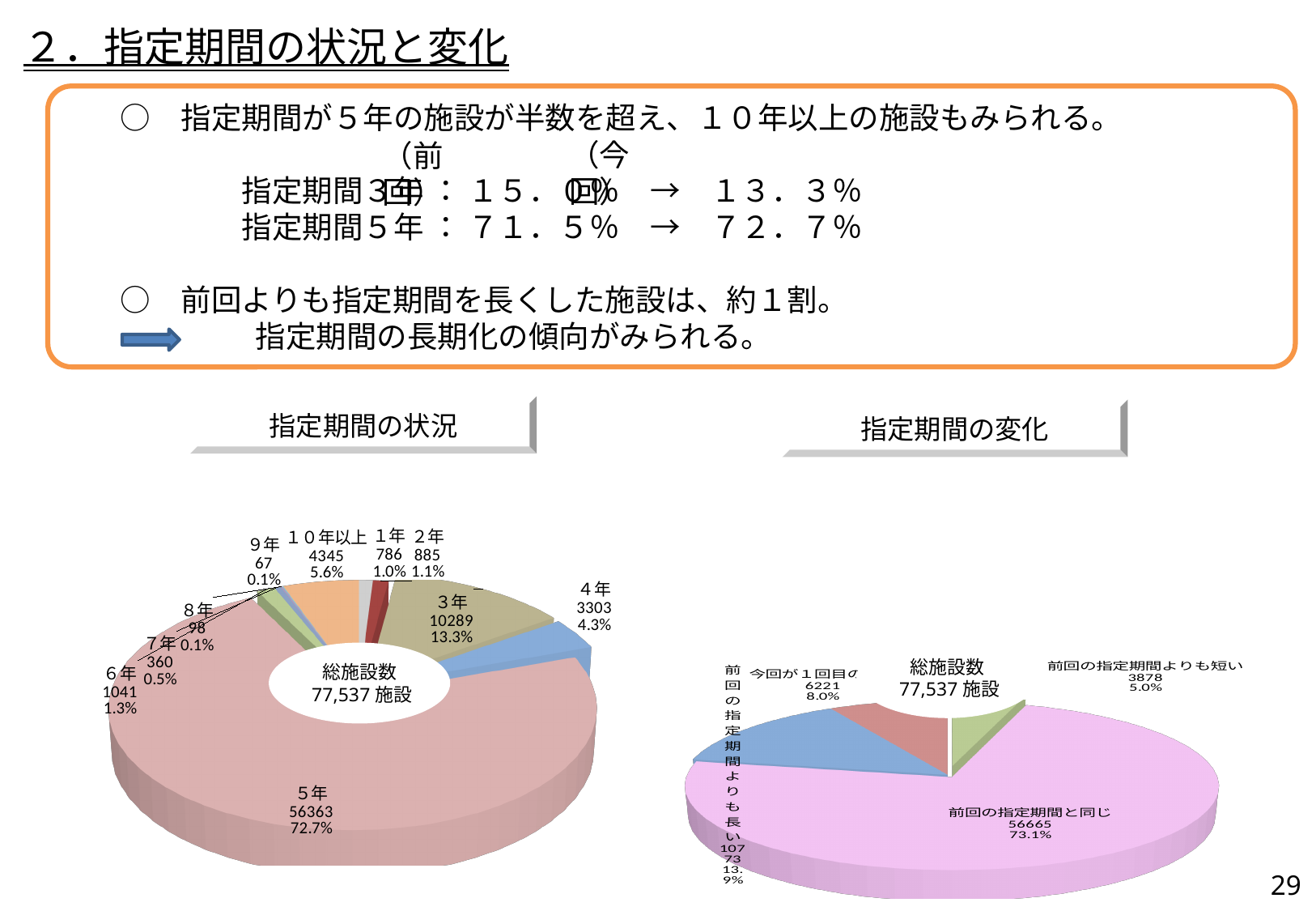
In the 指定期間の状況 chart on the left, how many facilities have a designation period of 5年? 56363 In the 指定期間の状況 chart on the left, what is the value shown for 10年以上? 4345 In the 指定期間の状況 chart on the left, what is the difference between the number of facilities for 3年 and 4年? 6986 What total number of facilities is shown in the centre of the 指定期間の状況 chart on the left? 77,537 施設 In the 指定期間の変化 chart on the right, what is the value for 前回の指定期間と同じ? 56665 In the 指定期間の変化 chart on the right, which category has the smallest share? 前回の指定期間よりも短い In the 指定期間の状況 chart on the left, which category has the largest share? 5年 What type of chart is the 指定期間の変化 chart on the right? Pie chart In the 指定期間の状況 chart on the left, what percentage share does 3年 have? 13.3% In the 指定期間の状況 chart on the left, how many categories are shown? 10 In the 指定期間の変化 chart on the right, what percentage share does 今回が１回目 have? 8.0% In the 指定期間の状況 chart on the left, which is larger, the value for 6年 or the value for 7年? 6年